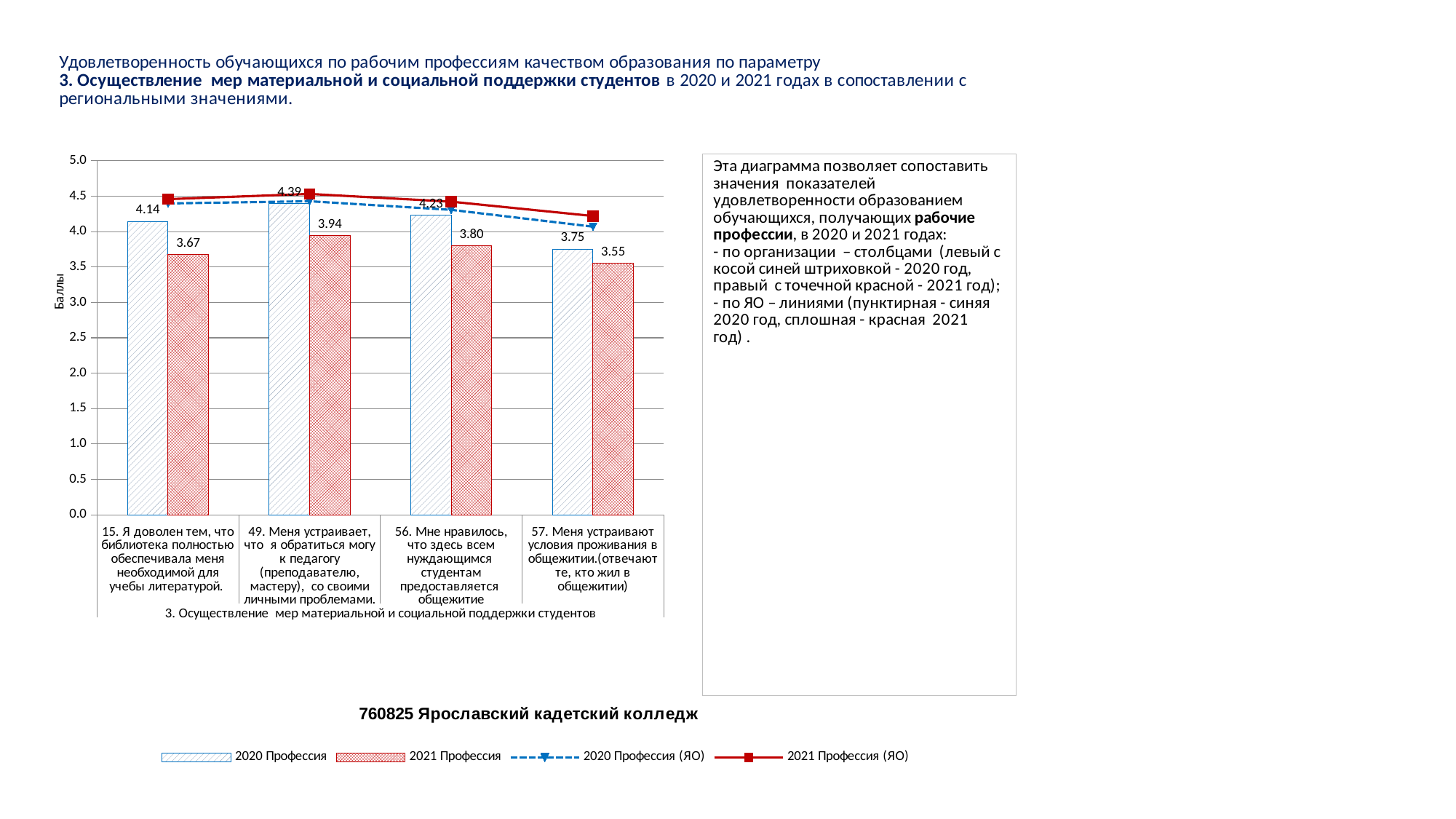
How many categories are shown on the x axis? 4 What is the label of the y axis? Баллы Which category has the highest 2020 Профессия bar? 49. Меня устраивает, что я обратиться могу к педагогу (преподавателю, мастеру), со своими личными проблемами. What is the difference between the 2020 Профессия and 2021 Профессия bars for category 56 (Мне нравилось, что здесь всем нуждающимся студентам предоставляется общежитие)? 0.43 What is the value of the 2020 Профессия bar for category 15 (Я доволен тем, что библиотека полностью обеспечивала меня необходимой для учебы литературой)? 4.14 What is the value of the 2021 Профессия bar for category 57 (Меня устраивают условия проживания в общежитии)? 3.55 What is the value of the 2021 Профессия bar for category 49 (Меня устраивает, что я обратиться могу к педагогу)? 3.94 Do the 2021 Профессия bar values rise or fall from category 49 to category 57? fall Which category has the lowest 2021 Профессия bar? 57. Меня устраивают условия проживания в общежитии.(отвечают те, кто жил в общежитии) How many series does the legend list? 4 For category 15, which bar is larger: 2020 Профессия or 2021 Профессия? 2020 Профессия Is the 2021 Профессия (ЯО) line value for category 57 greater or less than 4.0? greater